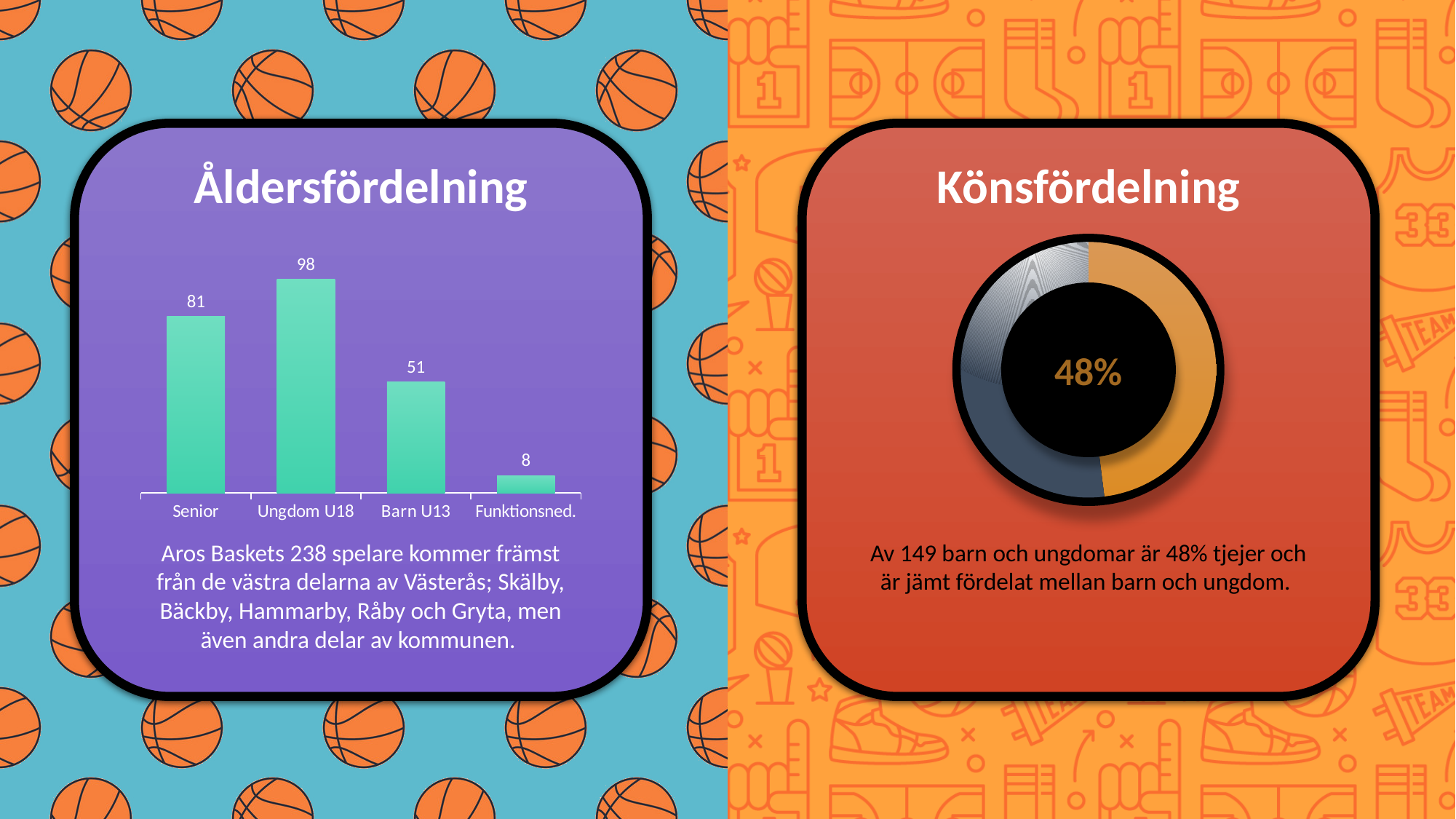
What kind of chart is the Åldersfördelning chart? Bar chart How many categories are shown in the Åldersfördelning chart? 4 What kind of chart is the Könsfördelning chart? Doughnut chart In the Åldersfördelning chart, which is larger, Senior or Barn U13? Senior In the Åldersfördelning chart, what is the value for Ungdom U18? 98 In the Åldersfördelning chart, what is the value for Senior? 81 In the Åldersfördelning chart, what is the value for Funktionsned.? 8 What percentage is shown in the centre of the Könsfördelning chart? 48% What is the total of all four bars in the Åldersfördelning chart? 238 In the Åldersfördelning chart, what is the difference between Ungdom U18 and Barn U13? 47 In the Åldersfördelning chart, which category has the lowest value? Funktionsned. In the Åldersfördelning chart, which category has the highest value? Ungdom U18